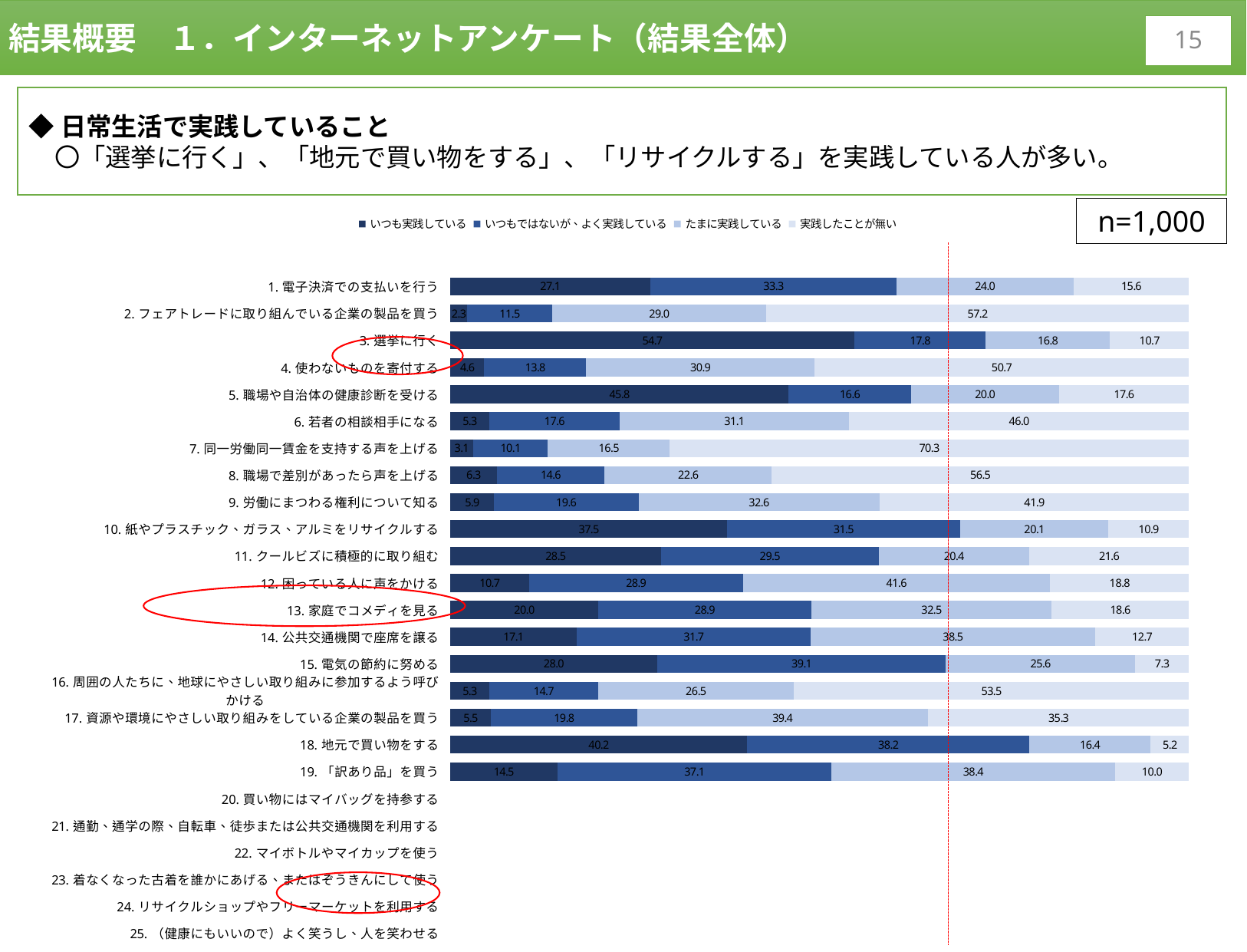
What is the value of 「いつも実践している」 for 「3. 選挙に行く」? 54.7 What is the value of 「たまに実践している」 for 「12. 困っている人に声をかける」? 41.6 Which item has the lowest value for 「いつも実践している」? 2. フェアトレードに取り組んでいる企業の製品を買う What is the difference between the 「いつも実践している」 values for 「3. 選挙に行く」 and 「5. 職場や自治体の健康診断を受ける」? 8.9 What is the value of 「いつもではないが、よく実践している」 for 「18. 地元で買い物をする」? 38.2 How many series does the chart legend list? 4 What kind of chart is shown on the slide? Stacked bar chart Which item has the highest value for 「いつも実践している」? 3. 選挙に行く Which item has the lowest value for 「実践したことが無い」? 18. 地元で買い物をする What is the sample size (n) shown on the slide? n=1,000 Which is larger: the 「実践したことが無い」 value for 「2. フェアトレードに取り組んでいる企業の製品を買う」 or for 「8. 職場で差別があったら声を上げる」? 2. フェアトレードに取り組んでいる企業の製品を買う What is the value of 「実践したことが無い」 for 「7. 同一労働同一賃金を支持する声を上げる」? 70.3